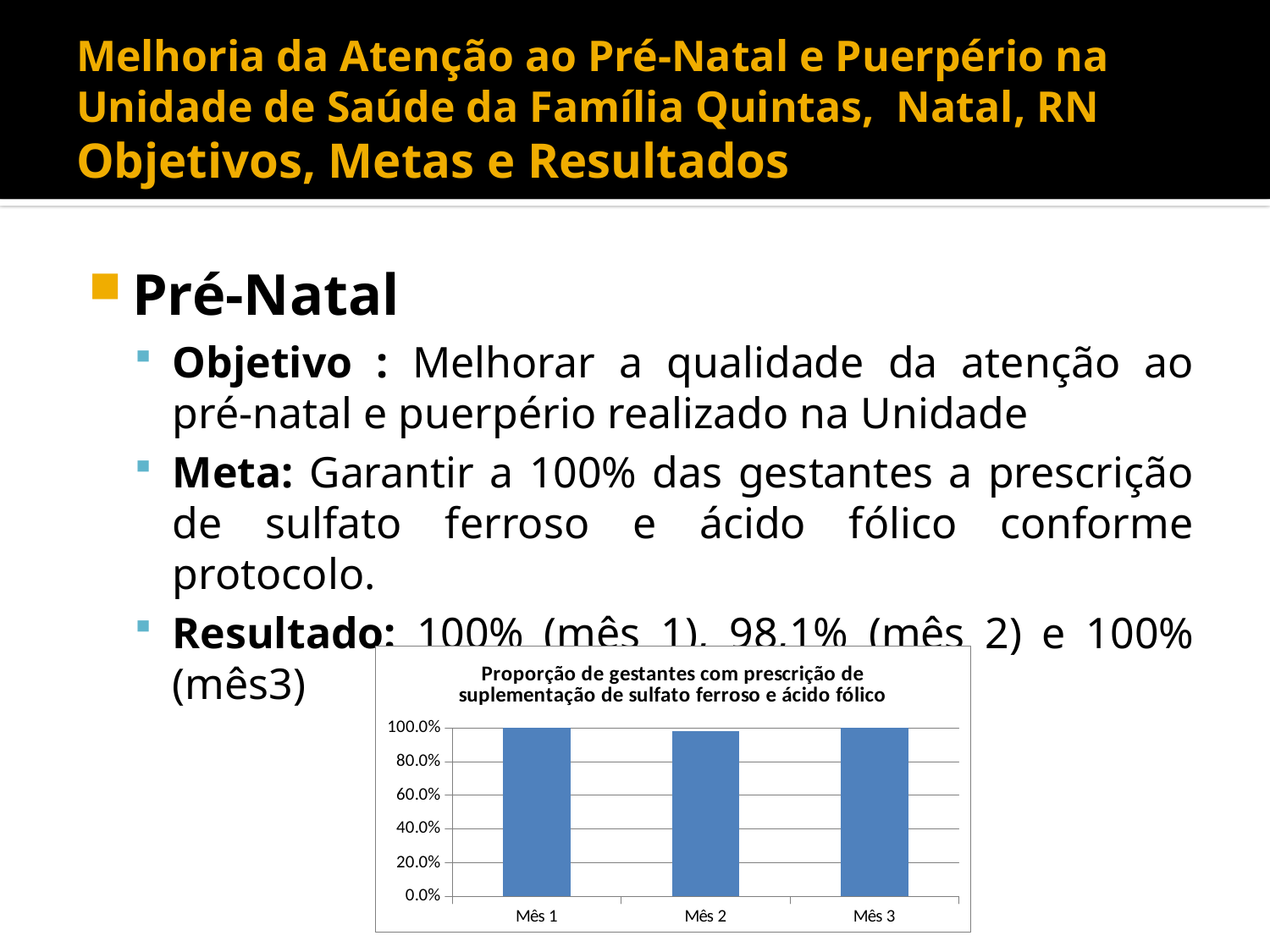
Do the values fall or rise from Mês 2 to Mês 3? rise What is the title of the chart? Proporção de gestantes com prescrição de suplementação de sulfato ferroso e ácido fólico How many categories (months) are plotted in the chart? 3 What is the difference between the value for Mês 1 and the value for Mês 2? 1.9% Is the value for Mês 2 greater or less than 80.0%? greater Which is larger, the value for Mês 1 or the value for Mês 2? Mês 1 What is the highest tick label shown on the vertical axis of the chart? 100.0% Which month has the lowest value in the chart? Mês 2 What is the value for Mês 2 in the chart? 98.1% What is the value for Mês 3 in the chart? 100% What kind of chart is shown on the slide? bar chart What is the value for Mês 1 in the chart? 100%